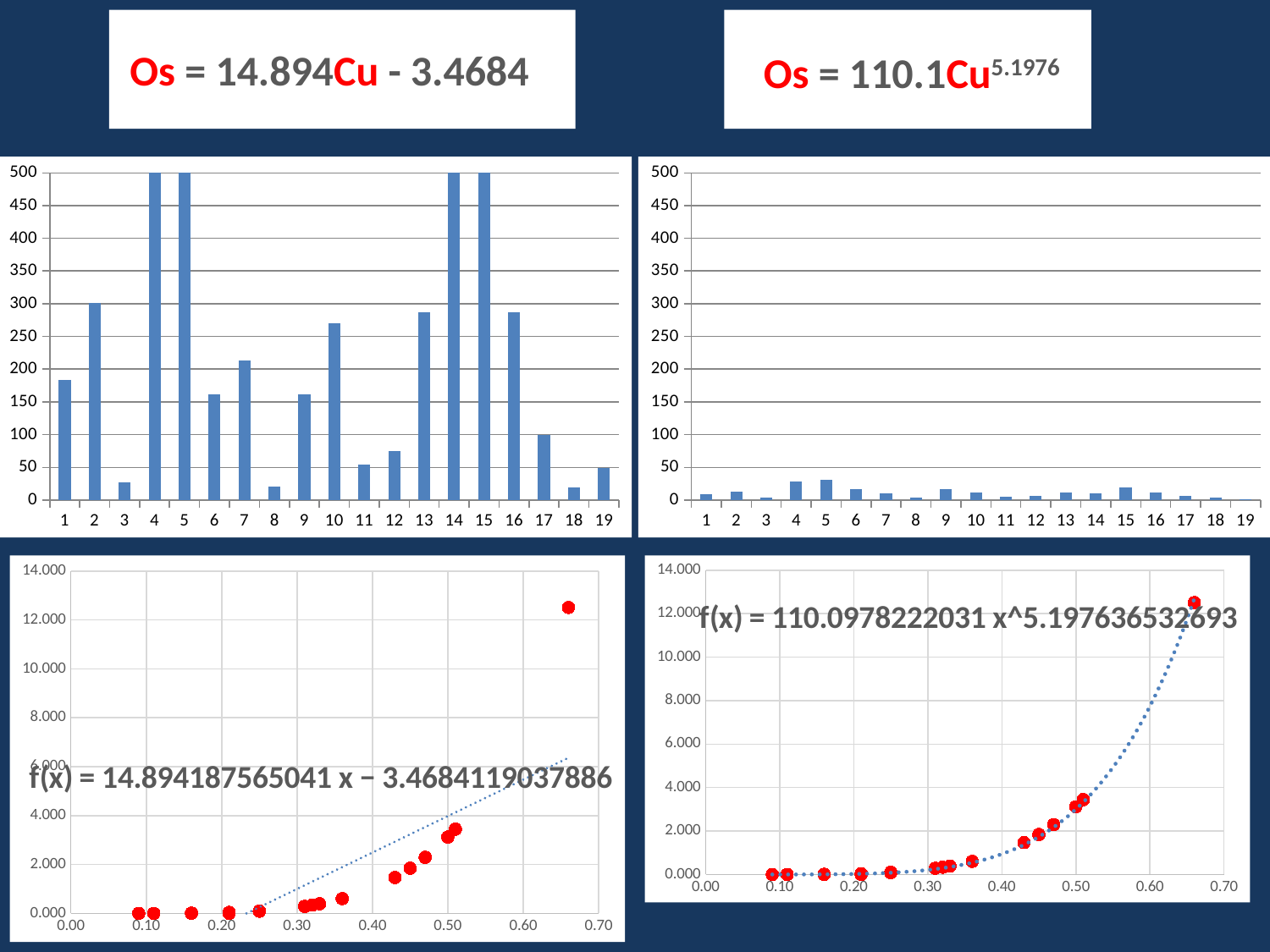
In the top-right bar chart, which is larger, the value for category 5 or the value for category 8? category 5 In the top-left bar chart, is the value for category 1 greater or less than 150? greater What trendline equation is printed on the bottom-right chart? f(x) = 110.0978222031 x^5.197636532693 In the top-left bar chart, is the value for category 7 greater or less than 200? greater What kind of chart is the bottom-right chart? scatter chart In the top-right bar chart, is the value for category 5 greater or less than 50? less In the top-left bar chart, which is larger, the value for category 2 or the value for category 3? category 2 What kind of chart is the top-left chart? bar chart How many categories are shown on the x axis of the top-left bar chart? 19